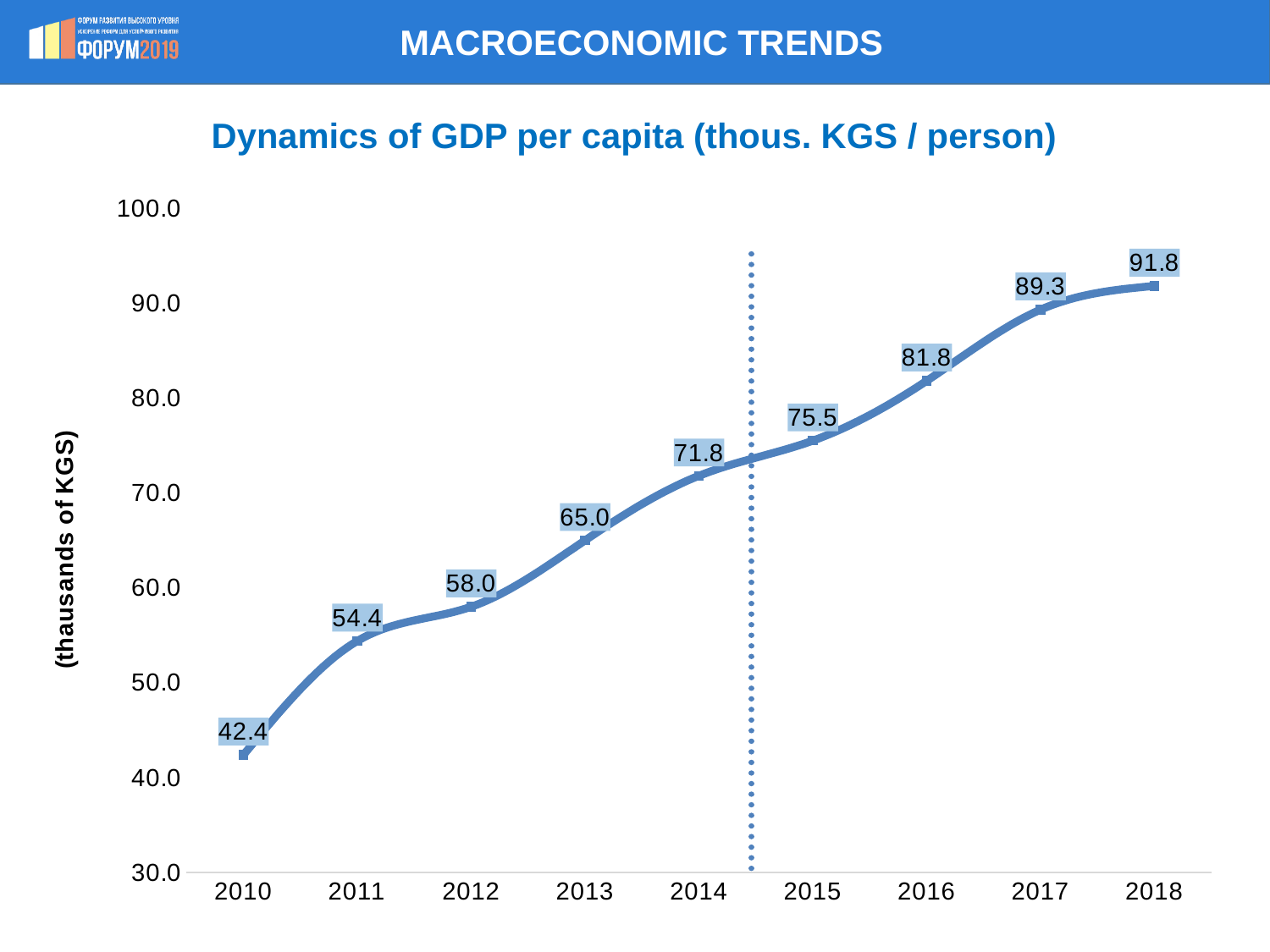
What is the difference between the GDP per capita in 2013 and in 2012? 7.0 Is the GDP per capita value for 2011 greater or less than 50.0? greater How many years are plotted on the chart? 9 What is the GDP per capita value for 2016? 81.8 Which is larger, the GDP per capita in 2015 or in 2017? 2017 What is the GDP per capita value for 2010? 42.4 What is the difference between the GDP per capita in 2018 and in 2010? 49.4 Do the GDP per capita values rise or fall from 2010 to 2018? rise What is the GDP per capita value for 2014? 71.8 Which year has the highest GDP per capita? 2018 Which year has the lowest GDP per capita? 2010 What kind of chart is shown on the slide? line chart